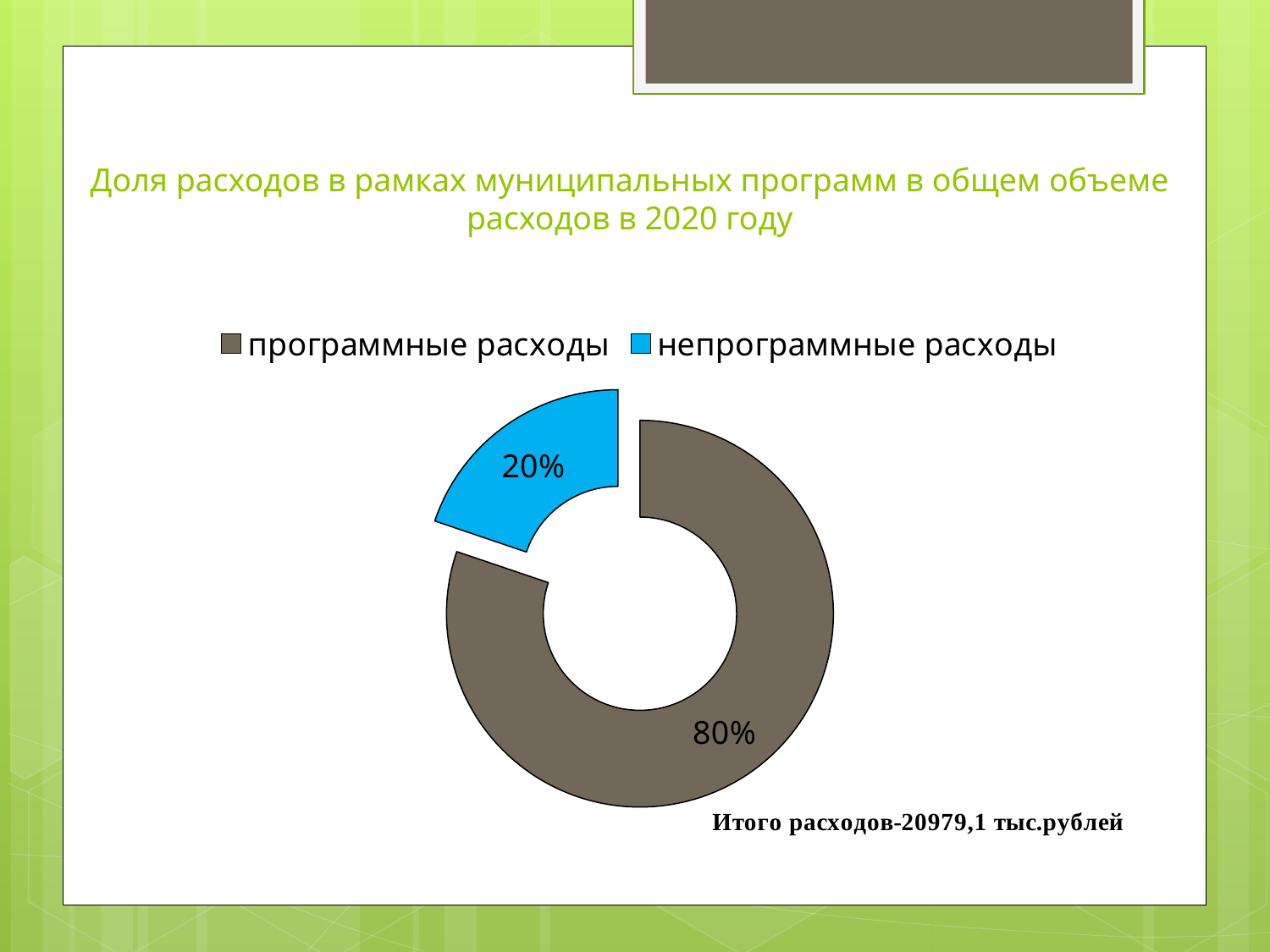
Which category has the largest share of the chart? программные расходы What is the difference in percentage points between программные расходы and непрограммные расходы? 60 percentage points Which is larger, the share for программные расходы or the share for непрограммные расходы? программные расходы What kind of chart is shown on the slide? Doughnut (pie) chart What colour is the slice for непрограммные расходы? Blue What total expenditure is stated below the chart? 20979,1 тыс.рублей What is the title of the chart? Доля расходов в рамках муниципальных программ в общем объеме расходов в 2020 году What share of the chart is labelled for программные расходы? 80% What share of the chart is labelled for непрограммные расходы? 20% How many entries does the legend list? 2 Which category has the smallest share of the chart? непрограммные расходы How many categories are shown in the chart? 2